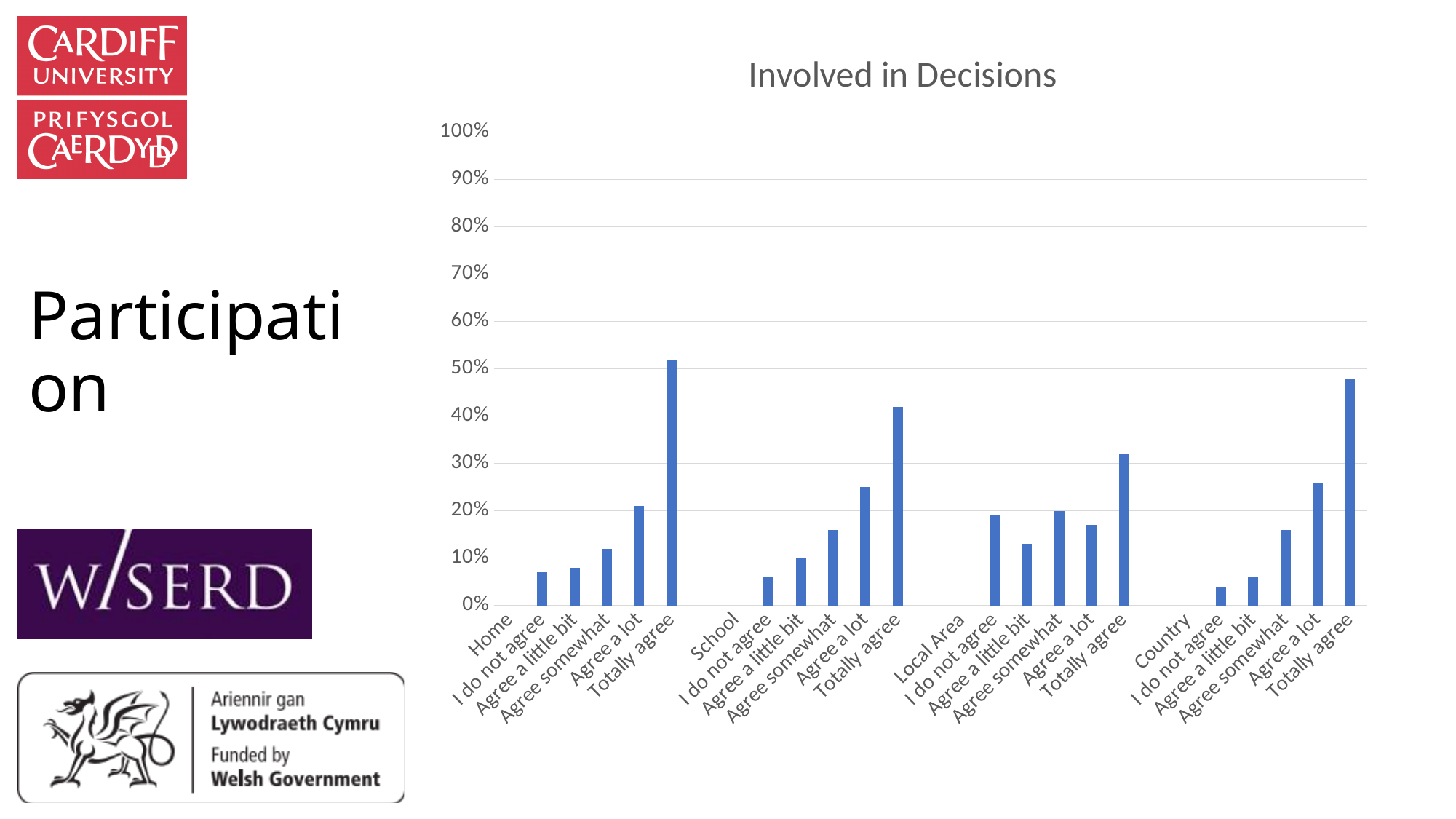
Is the value for Totally agree in the Home group greater or less than 40%? greater What is the highest value shown on the y axis? 100% Is the value for Totally agree in the Local Area group greater or less than 40%? less How many bars are plotted in the chart? 20 Within the Home group, which response has the highest value? Totally agree Within the Country group, which response has the lowest value? I do not agree Within the Local Area group, which response has the highest value? Totally agree What kind of chart is shown on the slide? bar chart Is the value for I do not agree in the Local Area group greater or less than 10%? greater How many group headings (Home, School, Local Area, Country) are shown along the x axis? 4 Which is larger: Totally agree in the School group or Totally agree in the Local Area group? Totally agree in the School group What is the title of the chart? Involved in Decisions